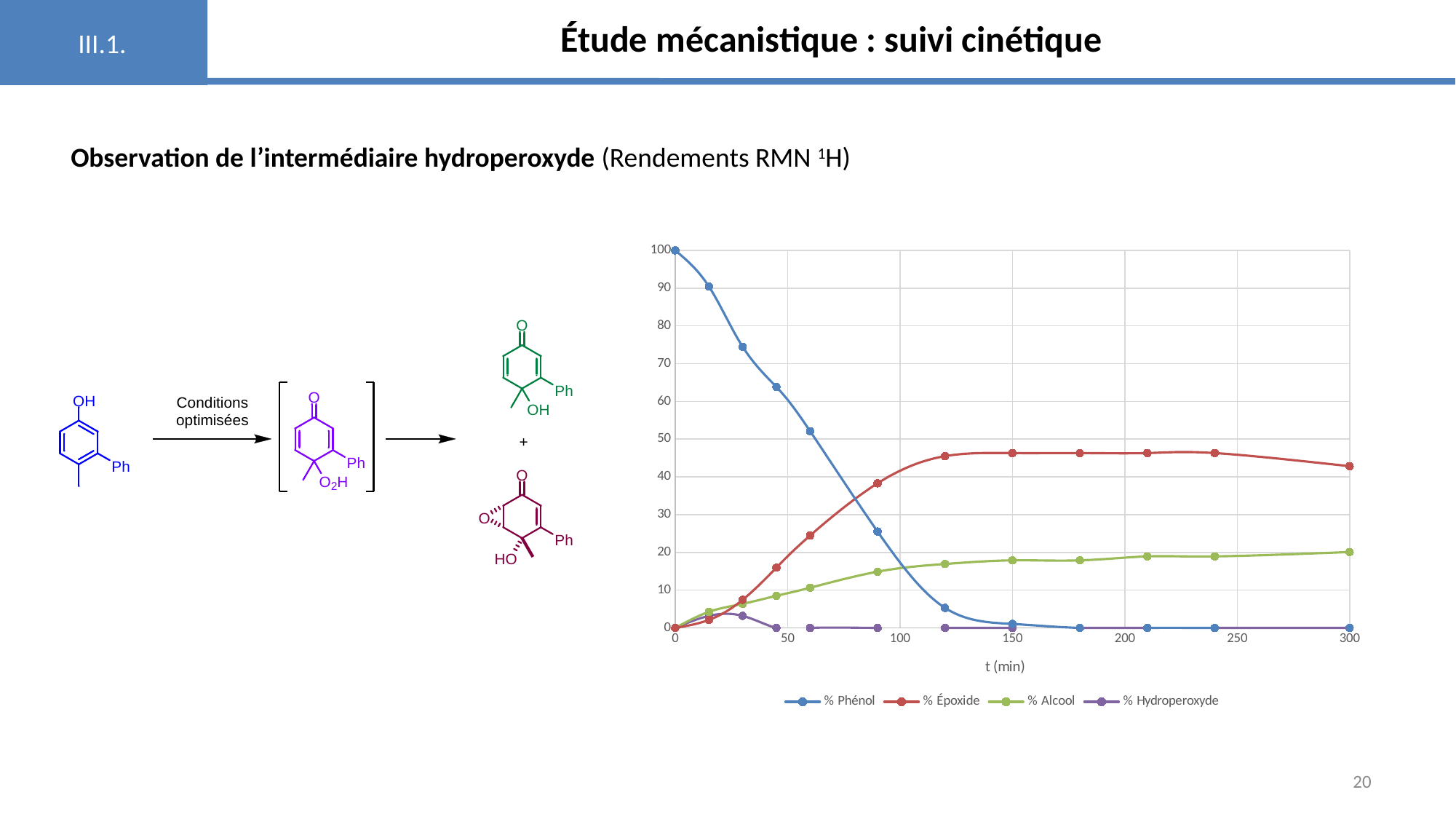
What is the label of the x axis of the chart? t (min) At t = 300, which series has the higher value, % Époxide or % Alcool? % Époxide Is the value of % Alcool at t = 300 greater or less than 30? less What kind of chart is shown on the slide? line chart Does the % Époxide series rise or fall over the first 100 minutes? rise Does the % Phénol series rise or fall as t increases? fall Is the value of % Époxide at t = 300 greater or less than 40? greater Is the value of % Phénol at t = 60 greater or less than 50? greater Which series has the highest value at t = 300? % Époxide Which series is plotted in blue? % Phénol What is the value of % Phénol at t = 0? 100 How many series does the chart legend list? 4